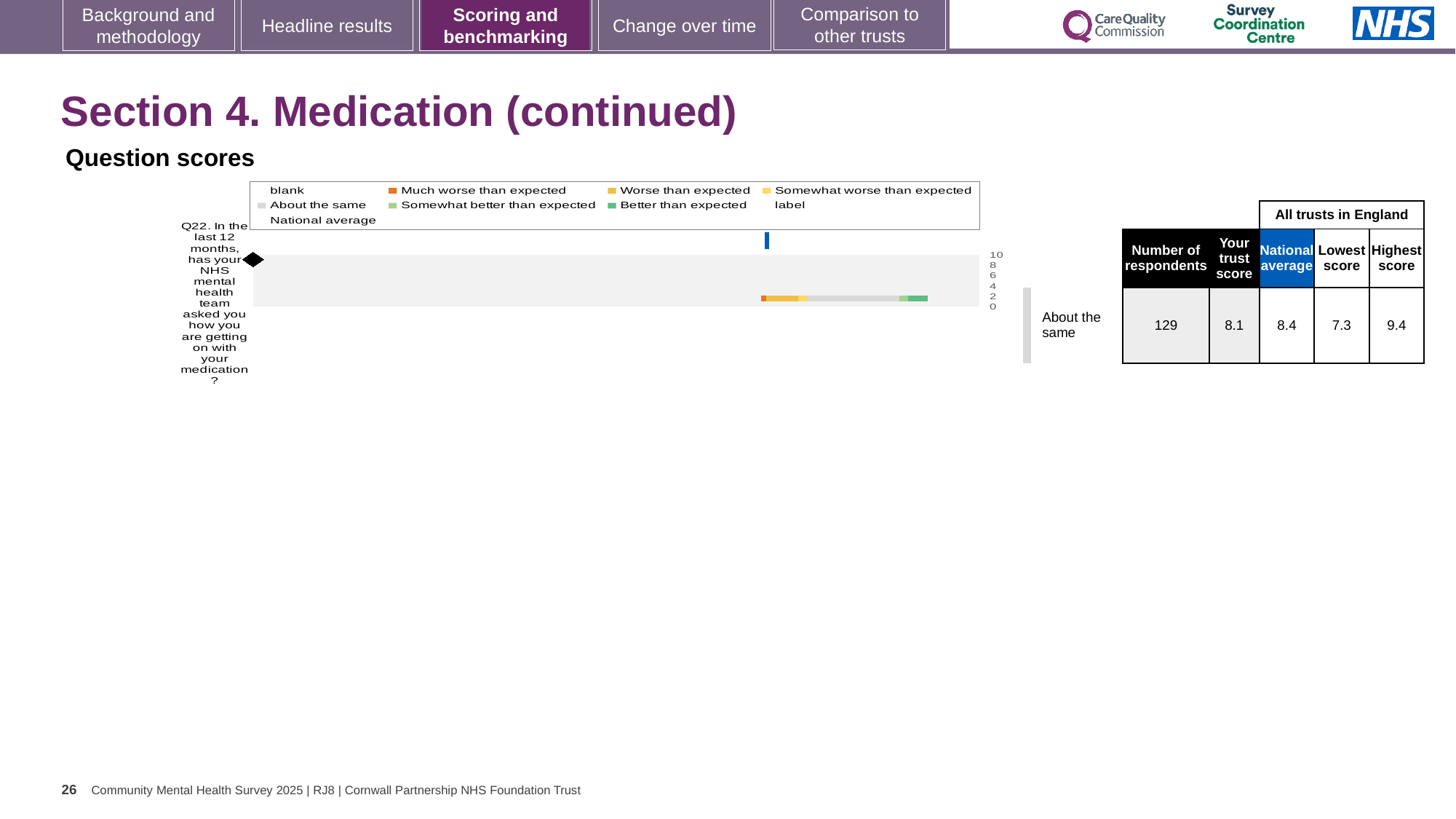
What is the national average for Q22 shown alongside the Question scores chart? 8.4 What is the lowest score across all trusts in England for Q22? 7.3 Which question number is plotted in the Question scores chart? Q22 What is the highest score across all trusts in England for Q22? 9.4 What benchmark category is shown next to the Question scores chart for Q22? About the same What kind of chart is shown under 'Question scores'? bar chart How many respondents answered Q22? 129 For Q22, what is the difference between the national average and the trust score? 0.3 For Q22, what is the difference between the highest score and the lowest score across all trusts in England? 2.1 What is the trust score for Q22 shown alongside the Question scores chart? 8.1 For Q22, which is larger: the trust score or the national average? National average How many questions are plotted in the Question scores chart? 1